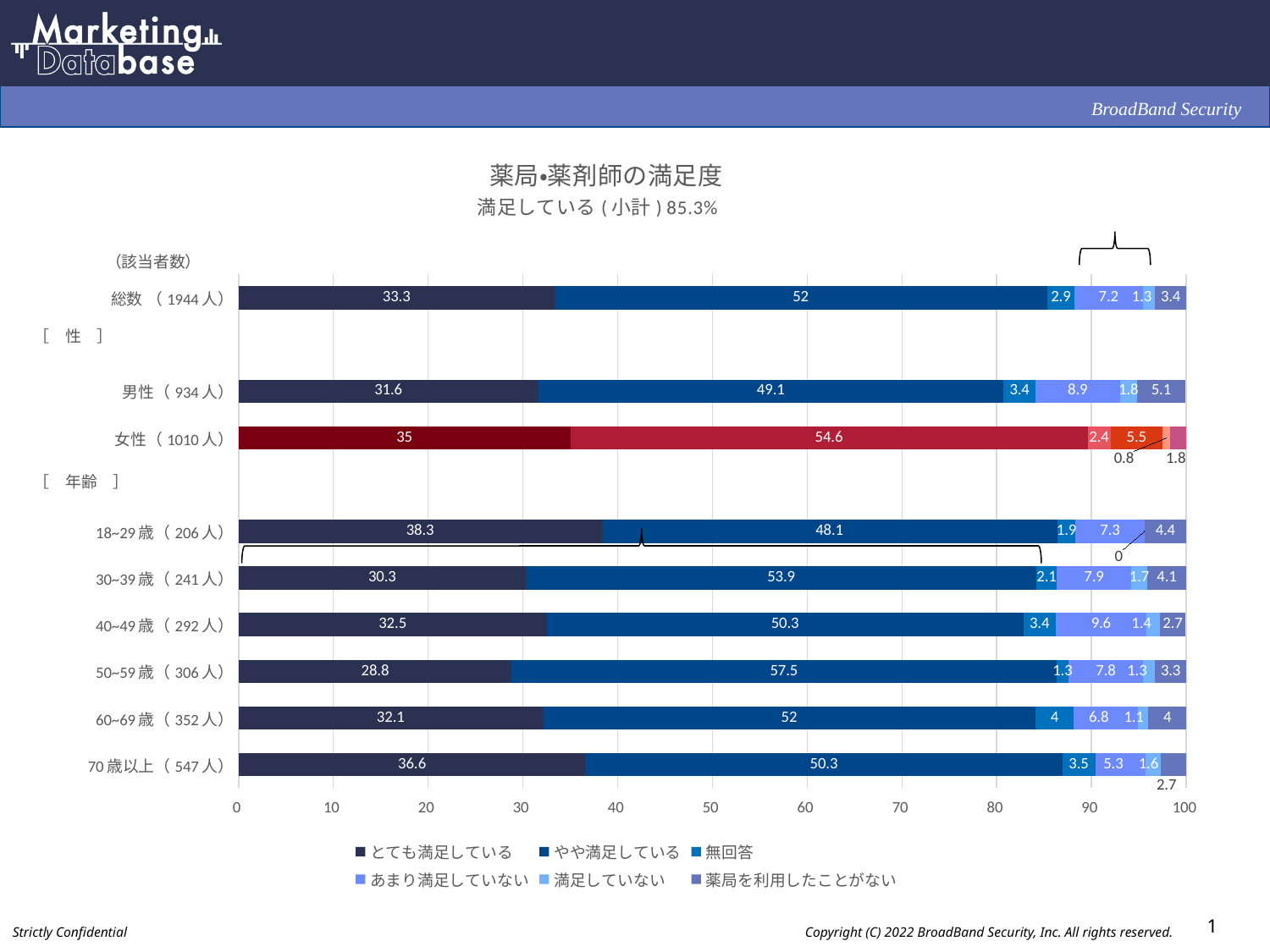
Which category has the lowest value for とても満足している? 50~59歳 (306人) What is the value of あまり満足していない for 40~49歳 (292人)? 9.6 How many series does the legend list? 6 What is the title of the chart? 薬局•薬剤師の満足度 How many categories (bars) are plotted in the chart? 9 Which category has the highest value for とても満足している? 18~29歳 (206人) What is the value of やや満足している for 女性 (1010人)? 54.6 Which is larger, the とても満足している value for 男性 (934人) or for 女性 (1010人)? 女性 (1010人) What is the value of とても満足している for 総数 (1944人)? 33.3 What is the value of 満足していない for 18~29歳 (206人)? 0 What kind of chart is shown on the slide? Stacked bar chart What is the difference between the やや満足している values for 50~59歳 (306人) and 18~29歳 (206人)? 9.4